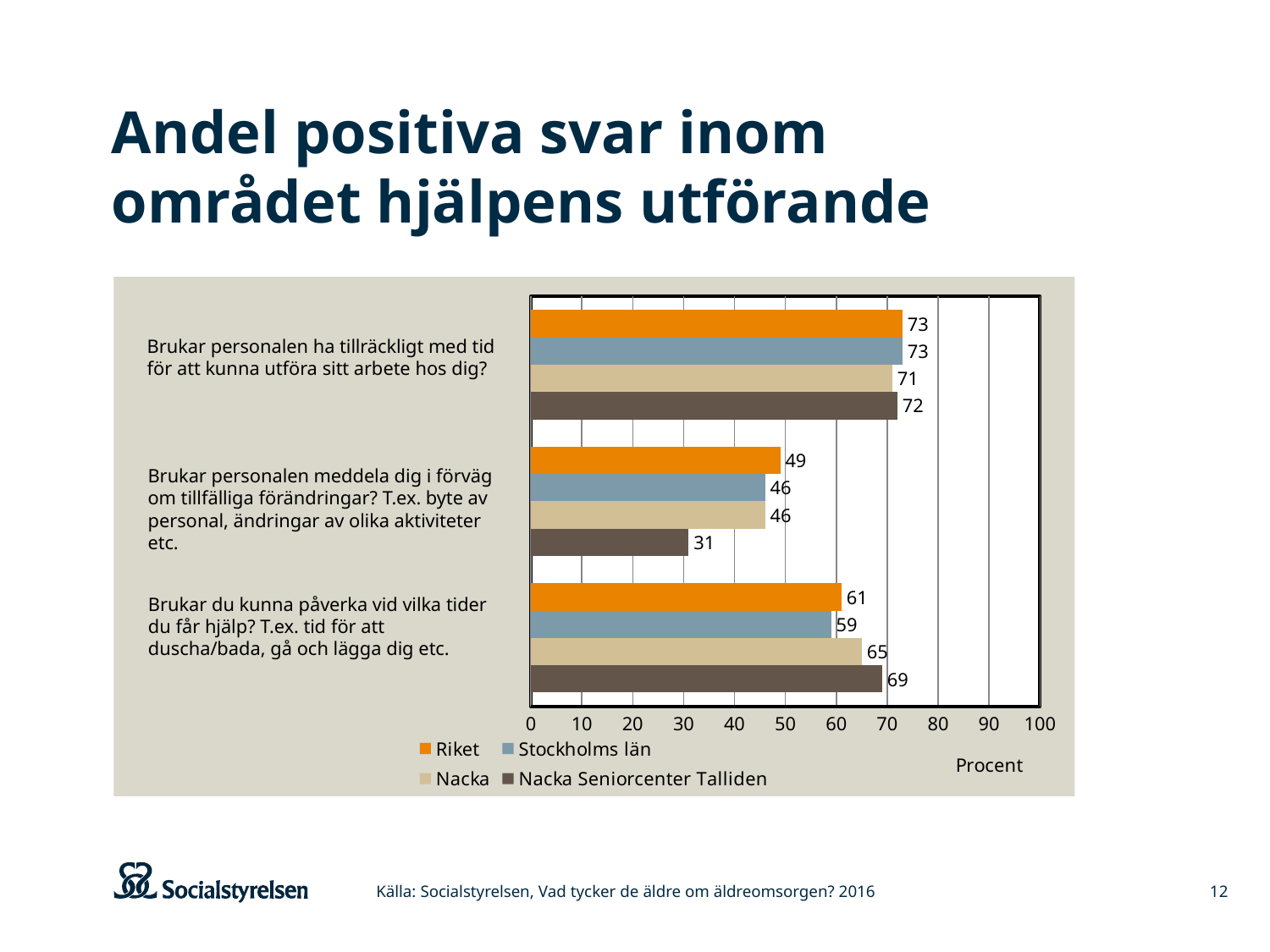
Is the value for Nacka Seniorcenter Talliden on the question "Brukar personalen ha tillräckligt med tid för att kunna utföra sitt arbete hos dig?" greater or less than 60? greater What is the value for Nacka on the question "Brukar du kunna påverka vid vilka tider du får hjälp?"? 65 Which series has the highest value on the question "Brukar du kunna påverka vid vilka tider du får hjälp?"? Nacka Seniorcenter Talliden Which series has the lowest value on the question "Brukar personalen meddela dig i förväg om tillfälliga förändringar?"? Nacka Seniorcenter Talliden How many series does the legend list? 4 How many questions (categories) are shown on the chart? 3 What is the value for Nacka Seniorcenter Talliden on the question "Brukar personalen meddela dig i förväg om tillfälliga förändringar?"? 31 Which is larger on the question "Brukar du kunna påverka vid vilka tider du får hjälp?": Riket or Stockholms län? Riket What is the value for Riket on the question "Brukar personalen ha tillräckligt med tid för att kunna utföra sitt arbete hos dig?"? 73 What is the difference between Riket and Nacka Seniorcenter Talliden on the question "Brukar personalen meddela dig i förväg om tillfälliga förändringar?"? 18 What is the label of the x axis? Procent What kind of chart is shown on the slide? Bar chart